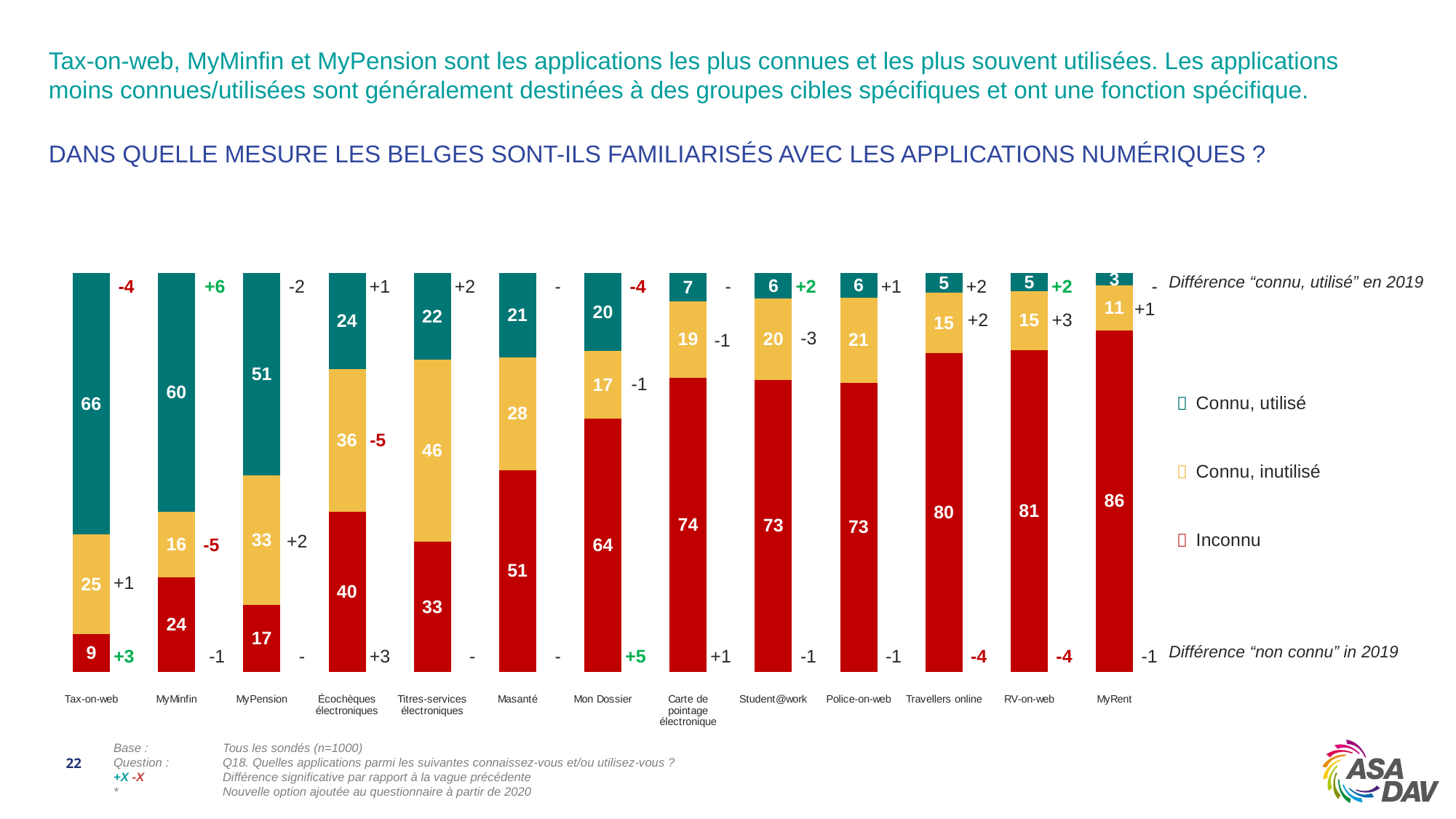
Which is larger: the "Connu, inutilisé" value for Écochèques électroniques or for MyPension? Écochèques électroniques Which application has the lowest "Inconnu" value? Tax-on-web What is the total of the stacked bar for MyMinfin? 100 What is the "Connu, inutilisé" value for Titres-services électroniques? 46 What is the "Connu, utilisé" value for Tax-on-web? 66 How many applications are shown on the x axis? 13 What kind of chart is shown on the slide? Stacked bar chart What is the "Inconnu" value for MyRent? 86 Which application has the highest "Connu, utilisé" value? Tax-on-web How many series does the legend list? 3 Which colour represents the "Inconnu" series? Red What is the difference between the "Inconnu" values for Mon Dossier and Masanté? 13